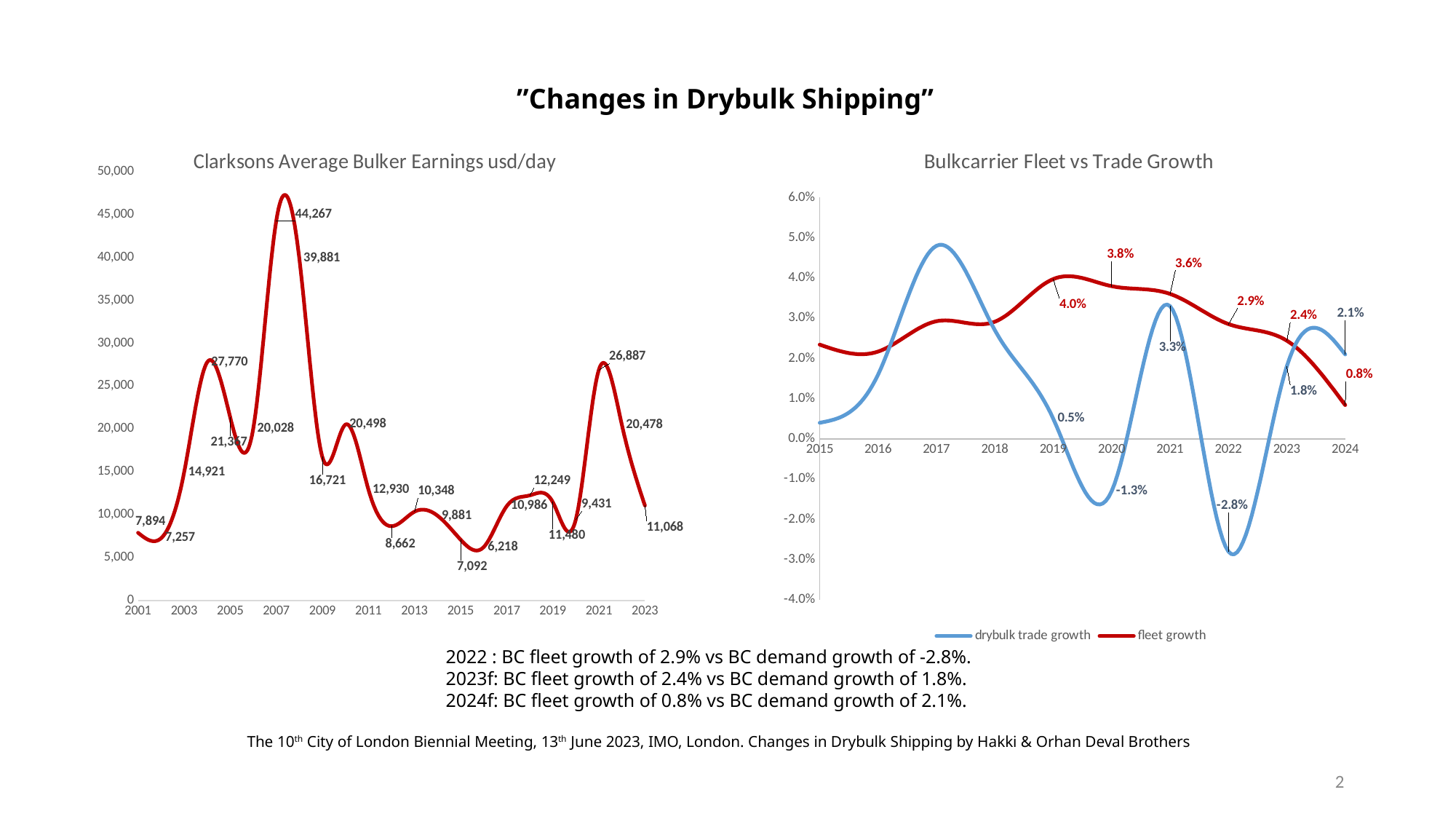
On the Clarksons Average Bulker Earnings chart, what is the value for 2021? 26,887 On the Clarksons Average Bulker Earnings chart, what is the lowest value shown? 6,218 On the Bulkcarrier Fleet vs Trade Growth chart, what is the fleet growth for 2022? 2.9% On the Bulkcarrier Fleet vs Trade Growth chart, what is the drybulk trade growth for 2022? -2.8% On the Bulkcarrier Fleet vs Trade Growth chart, does fleet growth rise or fall from 2019 to 2024? fall On the Bulkcarrier Fleet vs Trade Growth chart, how many series does the legend list? 2 What kind of chart is the Bulkcarrier Fleet vs Trade Growth chart? line chart On the Clarksons Average Bulker Earnings chart, what is the difference between the highest value (44,267) and the lowest value (6,218)? 38,049 On the Clarksons Average Bulker Earnings chart, how many years are plotted? 23 On the Clarksons Average Bulker Earnings chart, what is the highest value shown? 44,267 On the Clarksons Average Bulker Earnings chart, what is the value for 2023? 11,068 On the Bulkcarrier Fleet vs Trade Growth chart, which is larger in 2024: fleet growth or drybulk trade growth? drybulk trade growth